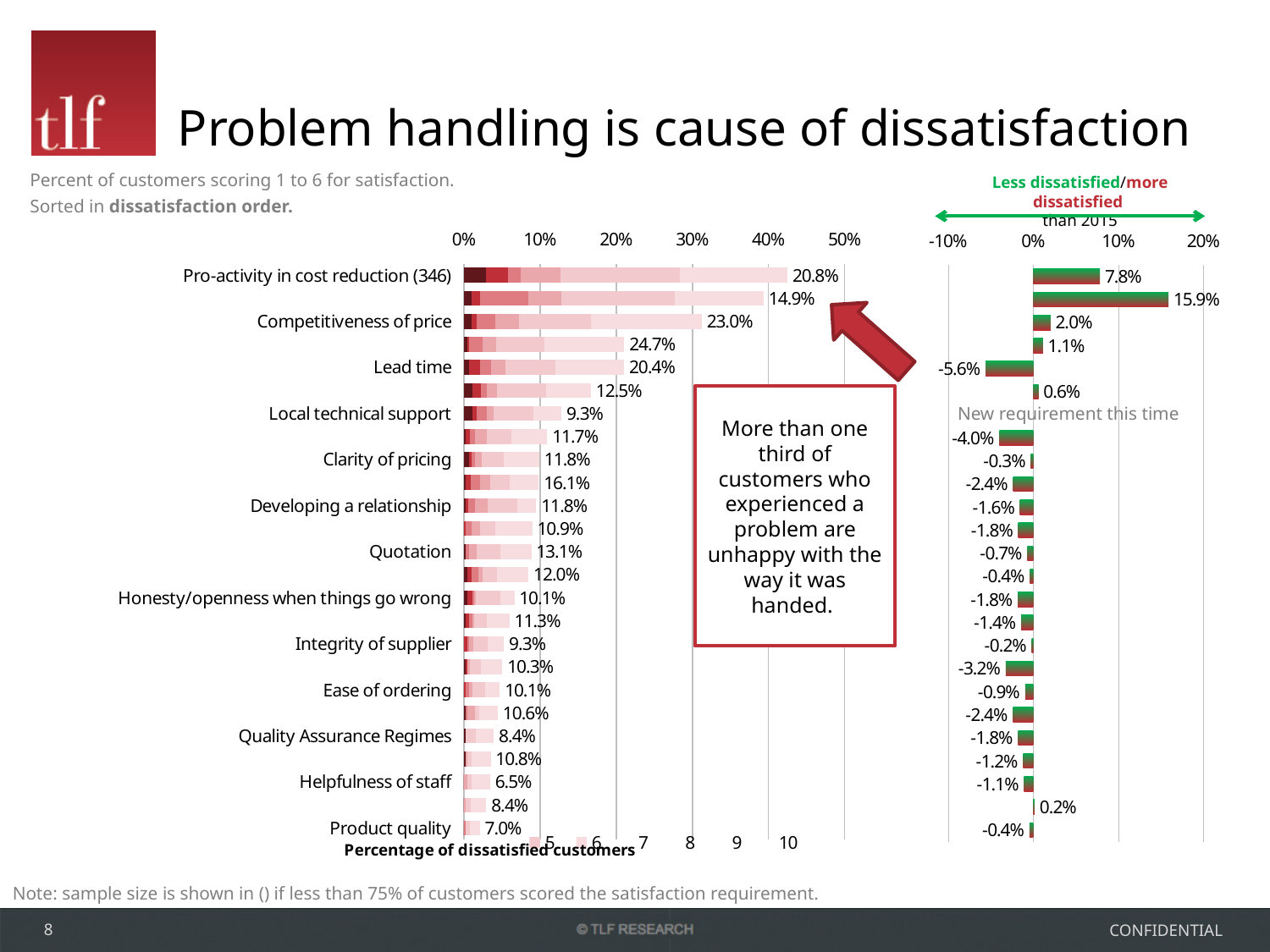
In the left chart (Percentage of dissatisfied customers), what is the difference between Competitiveness of price and Lead time? 2.6 percentage points In the left chart (Percentage of dissatisfied customers), what is the value for Helpfulness of staff? 6.5% In the left chart (Percentage of dissatisfied customers), which category has the lowest value? Helpfulness of staff In the left chart (Percentage of dissatisfied customers), is the value for Competitiveness of price greater or less than 20%? greater In the left chart (Percentage of dissatisfied customers), what is the value for Competitiveness of price? 23.0% What is the x-axis title of the left chart? Percentage of dissatisfied customers In the left chart (Percentage of dissatisfied customers), which is larger: Quotation or Clarity of pricing? Quotation What kind of chart is the left chart (Percentage of dissatisfied customers)? Stacked bar chart In the right chart (change versus 2015), what is the value for Pro-activity in cost reduction (346)? 7.8% In the left chart (Percentage of dissatisfied customers), what is the value for Pro-activity in cost reduction (346)? 20.8% In the right chart (change versus 2015), what is the value for Lead time? -5.6% In the right chart (change versus 2015), which labelled category has the lowest value? Lead time